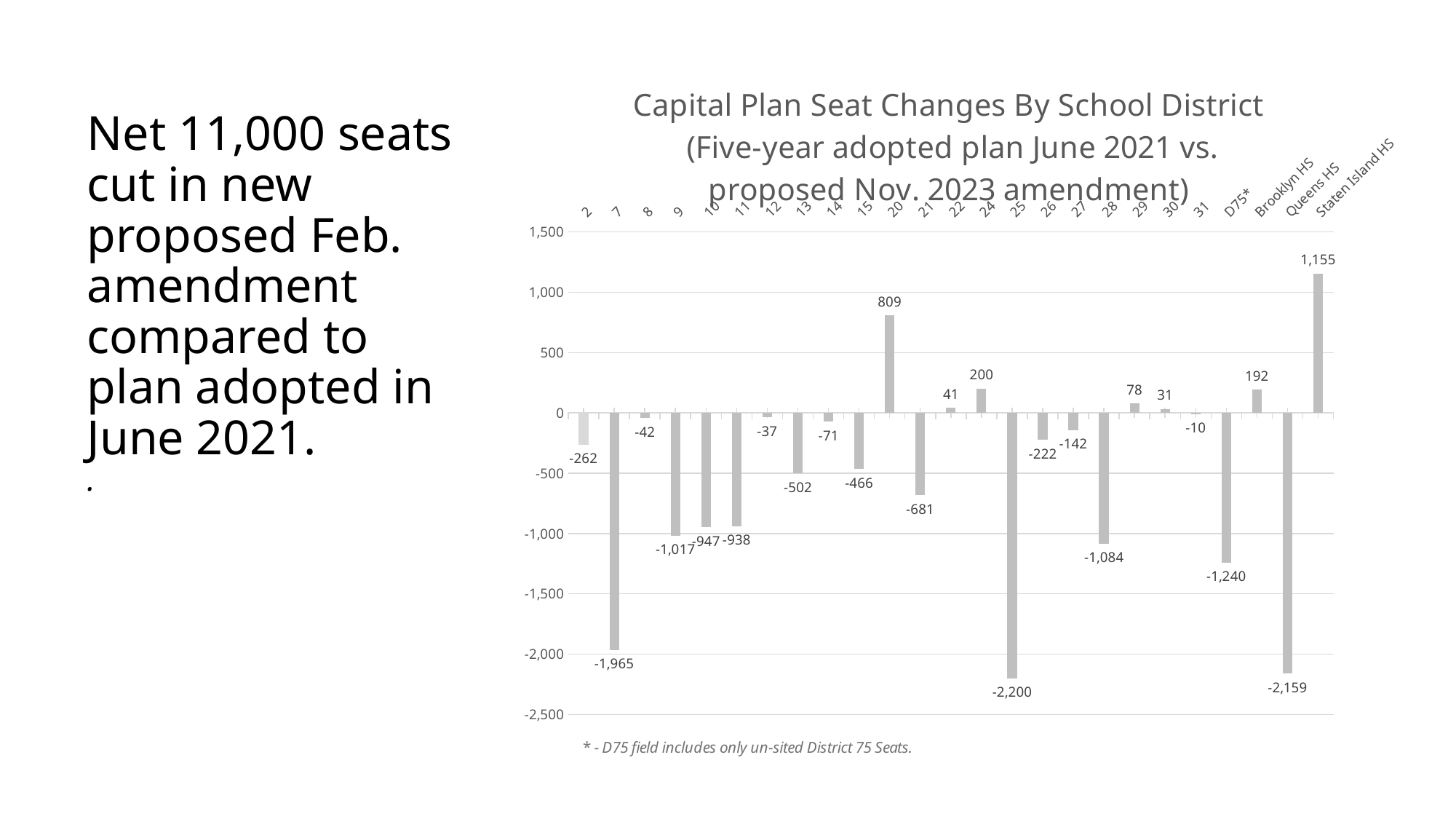
What is the difference between the values for district 25 and Queens HS? 41 Which category has the lowest value? 25 What is the value for district 20? 809 Which category has the highest value? Staten Island HS What is the value for Queens HS? -2,159 What kind of chart is this? bar chart What is the value for district 31? -10 Is the value for district 7 greater or less than -1,500? less What is the difference between the values for Staten Island HS and district 20? 346 How many categories are shown on the x axis? 25 Which has the larger value, district 24 or district 29? 24 What is the value for D75*? -1,240